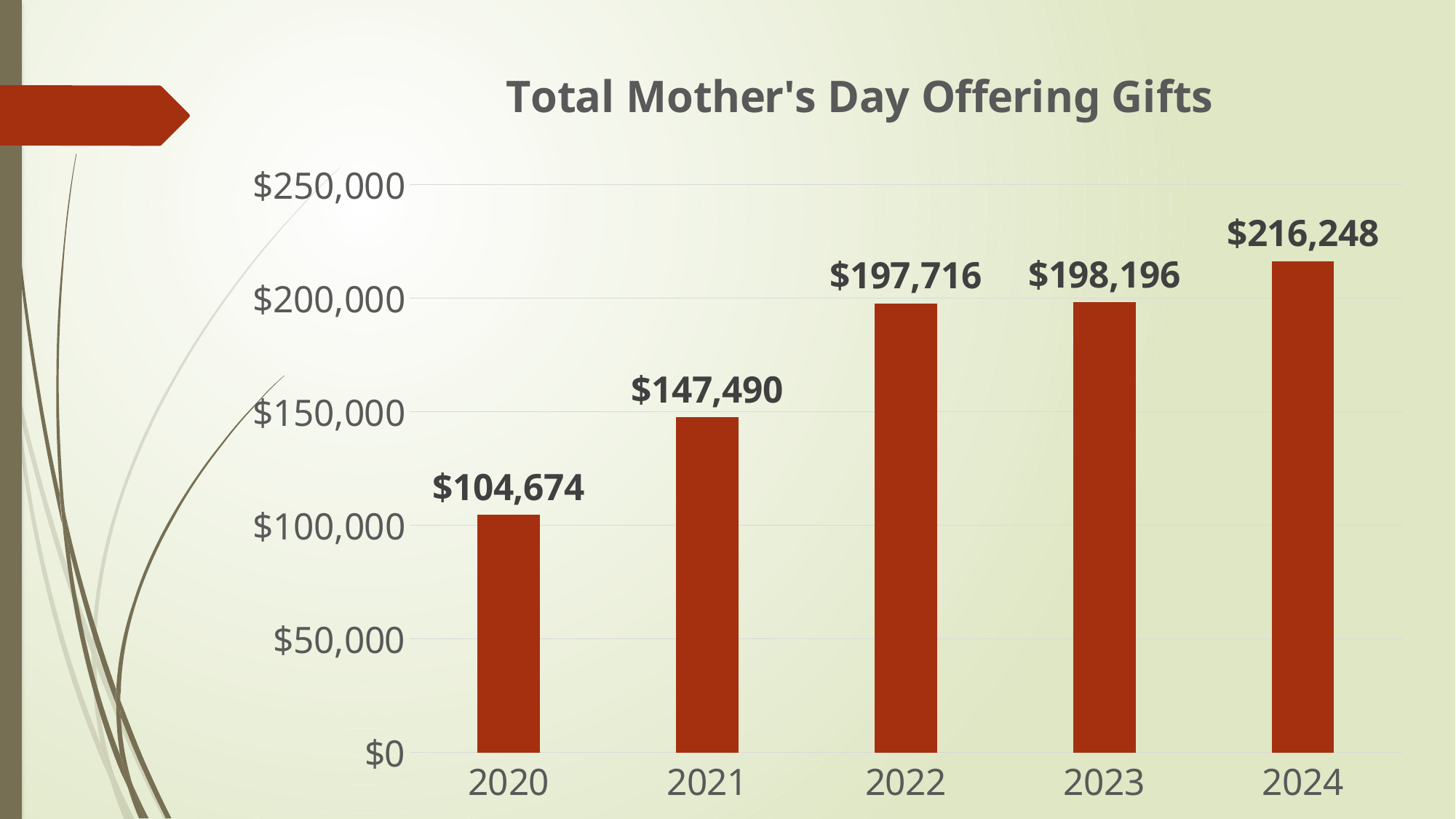
Is the value for 2021 greater or less than $150,000? less What is the difference between the values for 2024 and 2023? $18,052 What kind of chart is shown on the slide? bar chart How many years are shown on the chart? 5 What is the difference between the values for 2021 and 2020? $42,816 What is the value for 2020? $104,674 What is the value for 2022? $197,716 Do the values rise or fall from 2020 to 2024? rise Which is larger, the value for 2021 or the value for 2022? 2022 Which year has the lowest total Mother's Day offering gifts? 2020 Which year has the highest total Mother's Day offering gifts? 2024 What is the value for 2024? $216,248